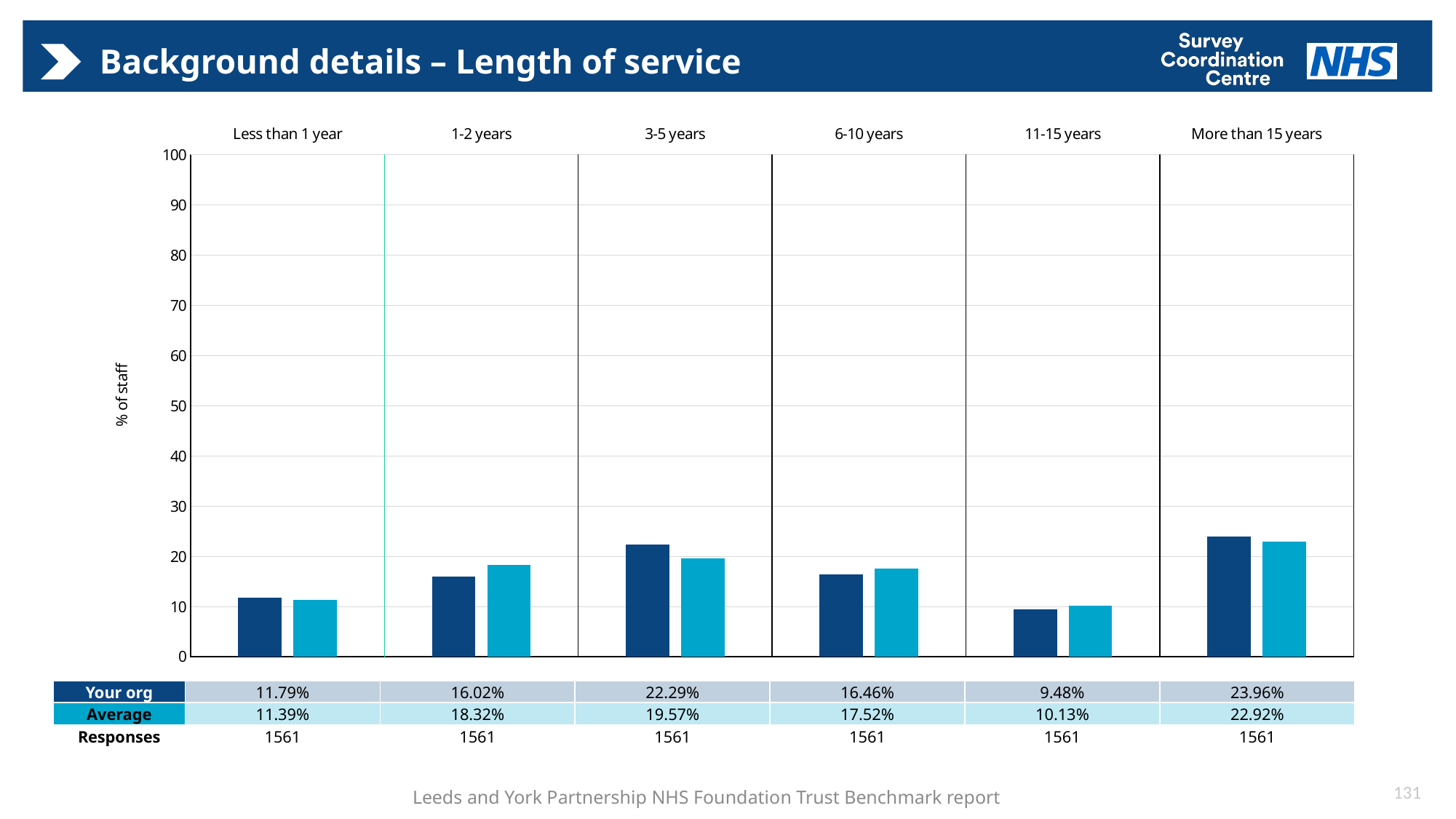
Which length of service category has the highest 'Your org' value? More than 15 years What kind of chart is shown on the slide? Bar chart What is the difference between the 'Your org' and 'Average' values for 3-5 years? 2.72% How many series does the chart show? 2 Which length of service category has the lowest 'Average' value? 11-15 years What is the number of responses shown for each category? 1561 How many length of service categories are shown on the chart? 6 For 1-2 years, which is larger: 'Your org' or 'Average'? Average Is the 'Your org' value for 11-15 years greater or less than 10? less What is the 'Average' value for 1-2 years? 18.32% What is the 'Your org' value for More than 15 years? 23.96% What is the 'Your org' value for 3-5 years? 22.29%